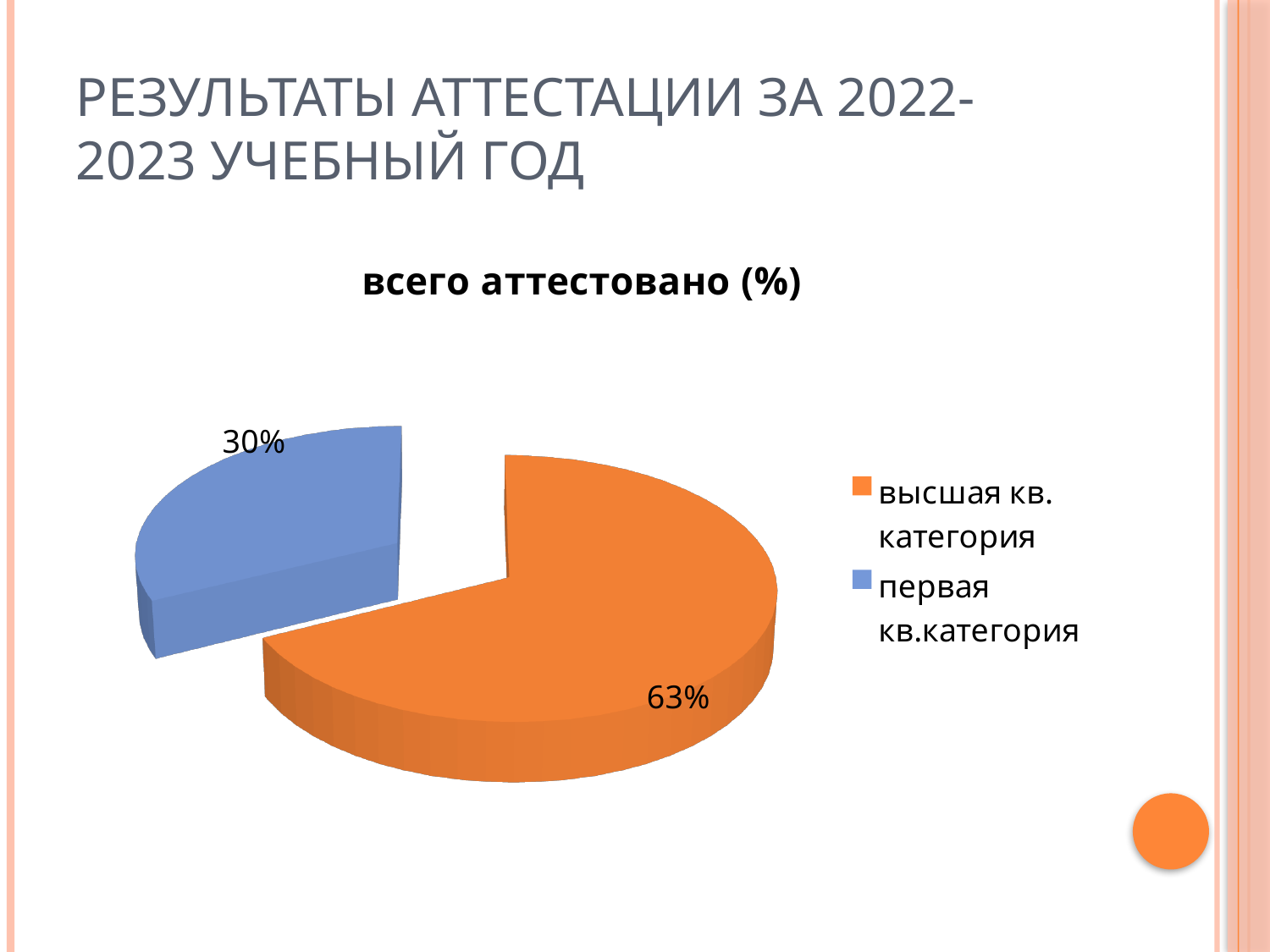
Which category has the smallest slice? первая кв.категория What is the difference between the values for высшая кв. категория and первая кв.категория? 33% How many slices does the pie chart have? 2 What colour is the slice for первая кв.категория? blue Which is larger, the value for высшая кв. категория or первая кв.категория? высшая кв. категория What is the value for первая кв.категория? 30% What is the value for высшая кв. категория? 63% What is the title of the chart? всего аттестовано (%) What kind of chart is shown on the slide? pie chart How many entries does the legend list? 2 Which category has the largest slice? высшая кв. категория